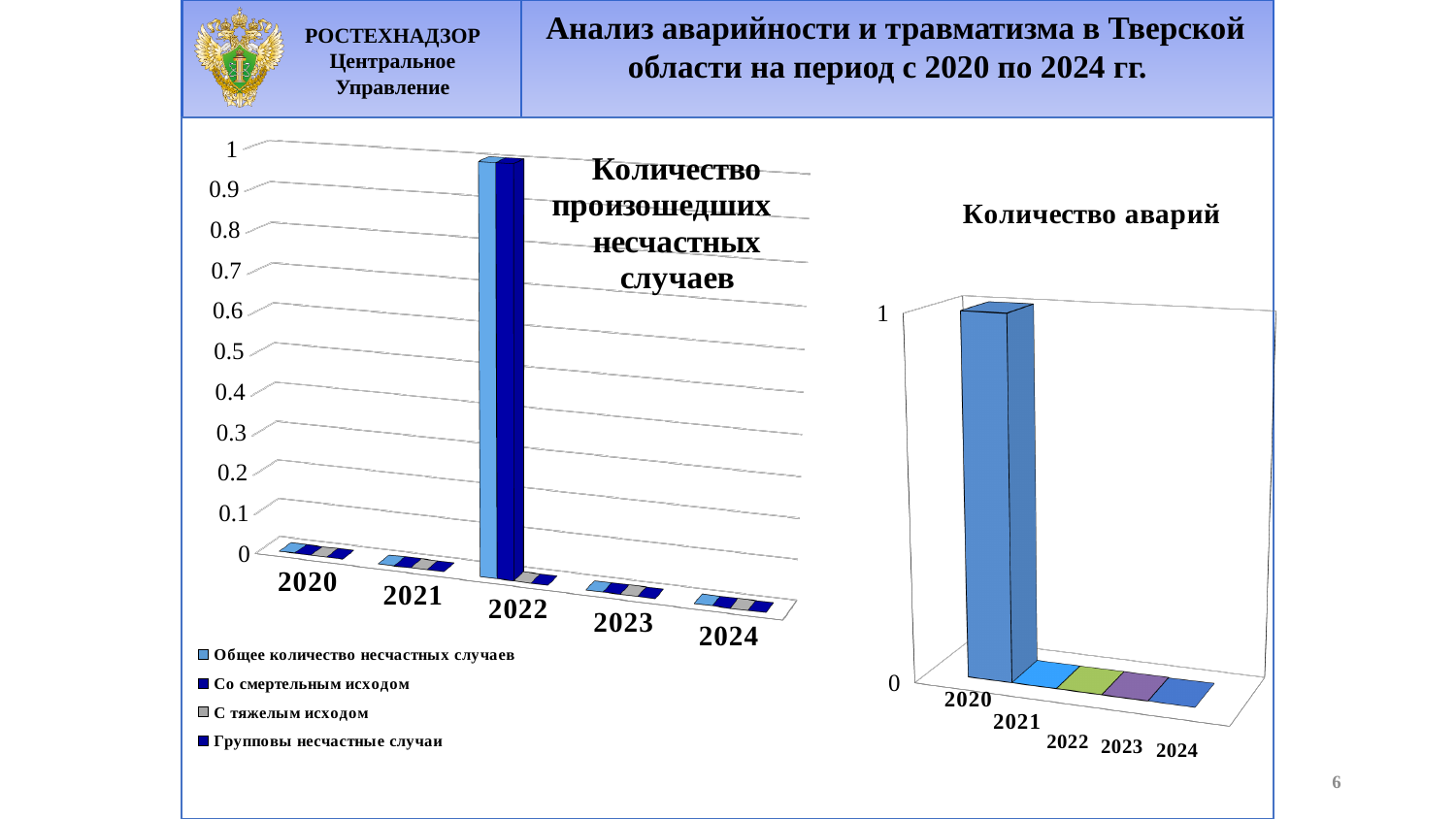
In the right chart "Количество аварий", what is the value for 2024? 0 In the left chart "Количество произошедших несчастных случаев", what is the value for "Со смертельным исходом" in 2022? 1 In the left chart "Количество произошедших несчастных случаев", how many series does the legend list? 4 In the left chart "Количество произошедших несчастных случаев", which year has the highest value for "Общее количество несчастных случаев"? 2022 In the left chart "Количество произошедших несчастных случаев", what is the value for "Общее количество несчастных случаев" in 2023? 0 In the left chart "Количество произошедших несчастных случаев", how many years are shown on the x axis? 5 What type of chart is the left chart titled "Количество произошедших несчастных случаев"? bar chart In the right chart "Количество аварий", which is larger, the value for 2020 or the value for 2021? 2020 In the right chart "Количество аварий", which year has the highest value? 2020 In the left chart "Количество произошедших несчастных случаев", what is the value for "Общее количество несчастных случаев" in 2022? 1 In the right chart "Количество аварий", what is the value for 2020? 1 In the left chart "Количество произошедших несчастных случаев", is the value for "Общее количество несчастных случаев" in 2022 greater or less than 0.5? greater